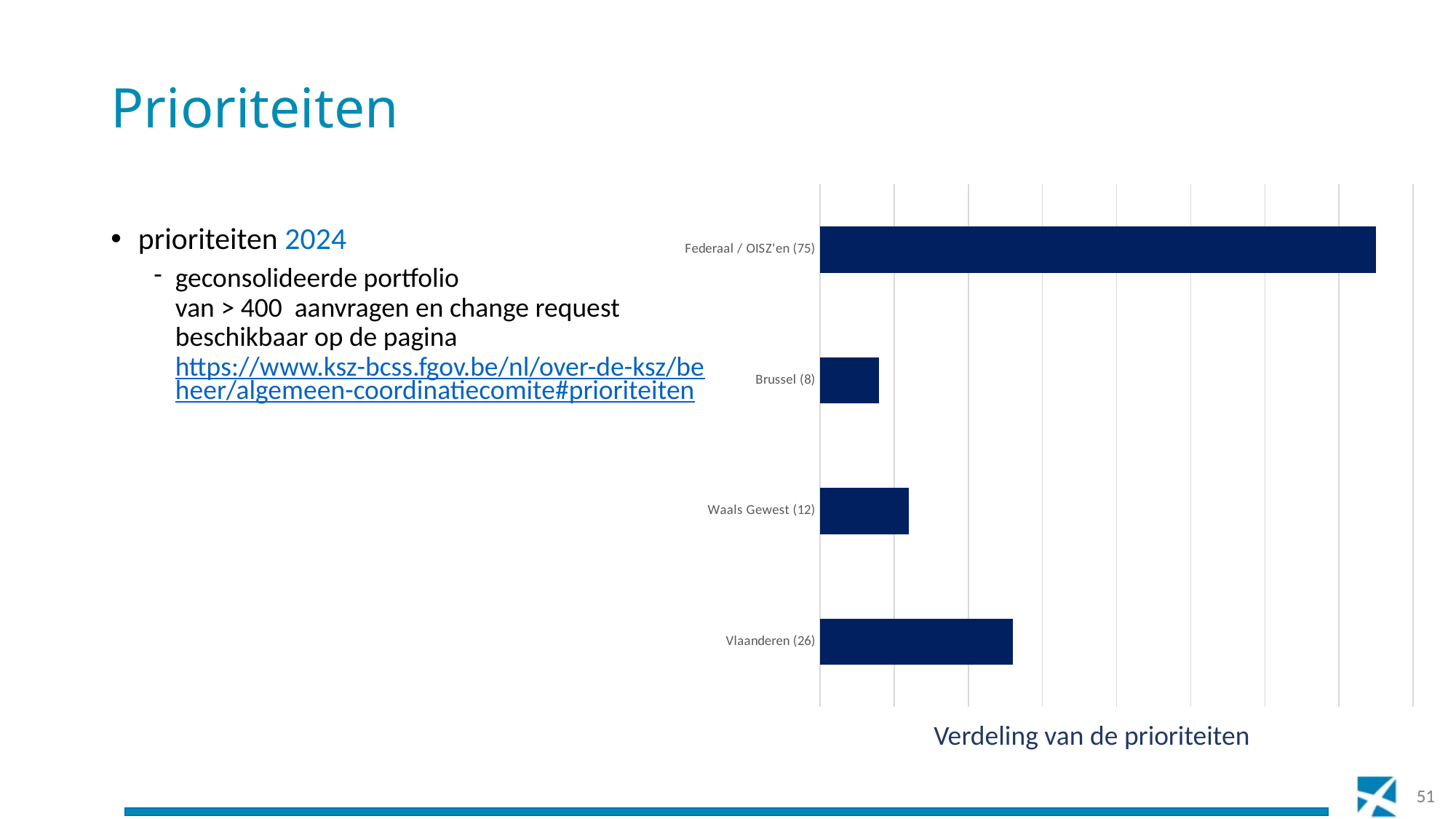
How many categories does the chart show? 4 What is the value shown for Federaal / OISZ'en? 75 What is the value shown for Waals Gewest? 12 What kind of chart is shown on the slide? bar chart What is the value shown for Vlaanderen? 26 Which is larger, the value for Waals Gewest or the value for Brussel? Waals Gewest What is the caption shown below the chart? Verdeling van de prioriteiten What is the value shown for Brussel? 8 What is the difference between the values for Vlaanderen and Waals Gewest? 14 Which category has the lowest value? Brussel Which category has the highest value? Federaal / OISZ'en What is the difference between the values for Federaal / OISZ'en and Vlaanderen? 49